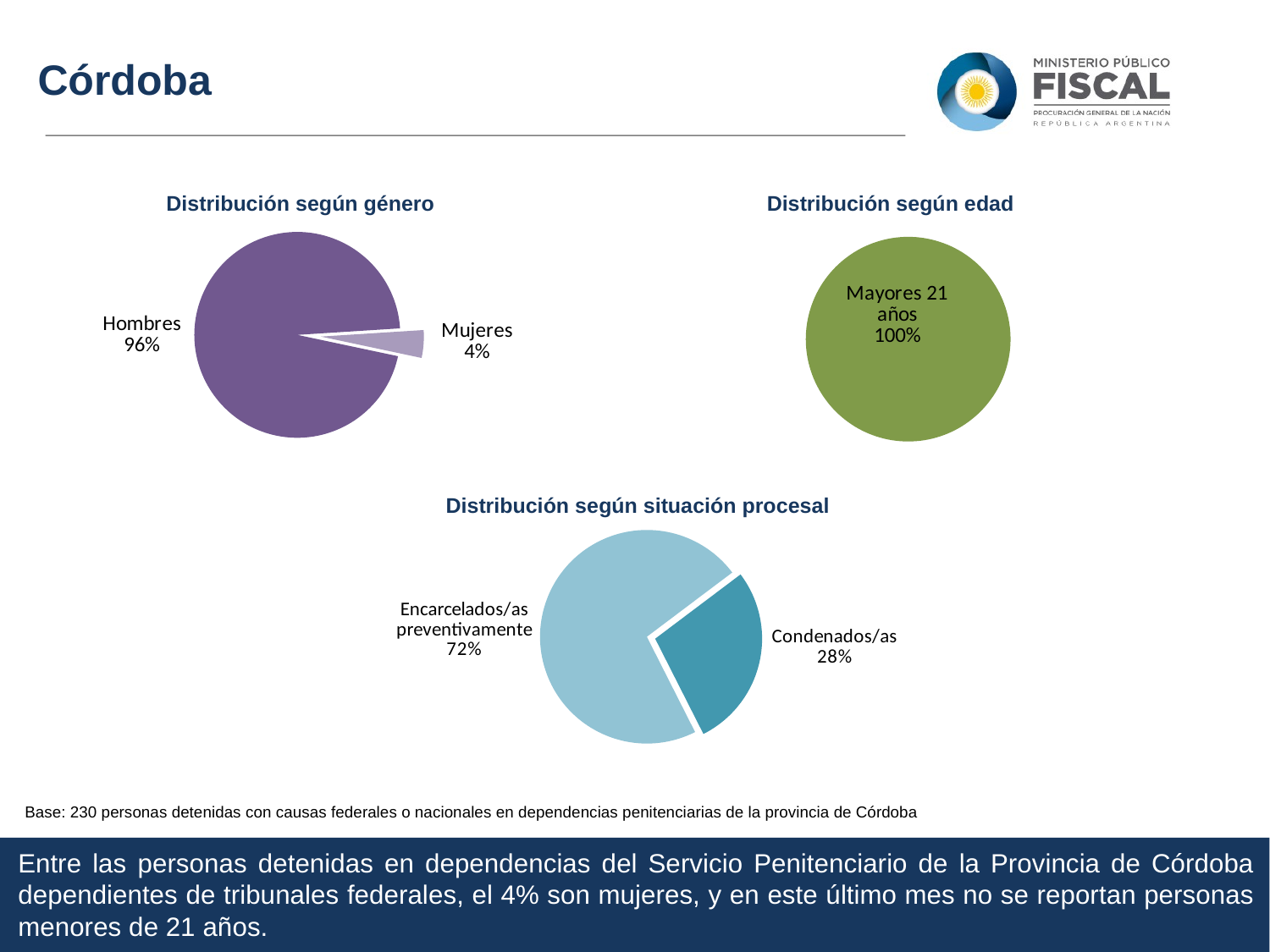
What kind of chart is 'Distribución según situación procesal'? Pie chart In the 'Distribución según situación procesal' chart, what share is labelled for Encarcelados/as preventivamente? 72% In the 'Distribución según género' chart, what share is labelled for Mujeres? 4% In the 'Distribución según situación procesal' chart, what is the difference in percentage points between Encarcelados/as preventivamente and Condenados/as? 44 How many charts are shown on the slide? 3 In the 'Distribución según edad' chart, what share is labelled for Mayores 21 años? 100% In the 'Distribución según género' chart, what is the difference in percentage points between Hombres and Mujeres? 92 How many slices does the 'Distribución según edad' chart show? 1 In the 'Distribución según situación procesal' chart, what share is labelled for Condenados/as? 28% In the 'Distribución según género' chart, what share is labelled for Hombres? 96% In the 'Distribución según género' chart, which slice is the largest? Hombres In the 'Distribución según situación procesal' chart, which slice is smaller? Condenados/as